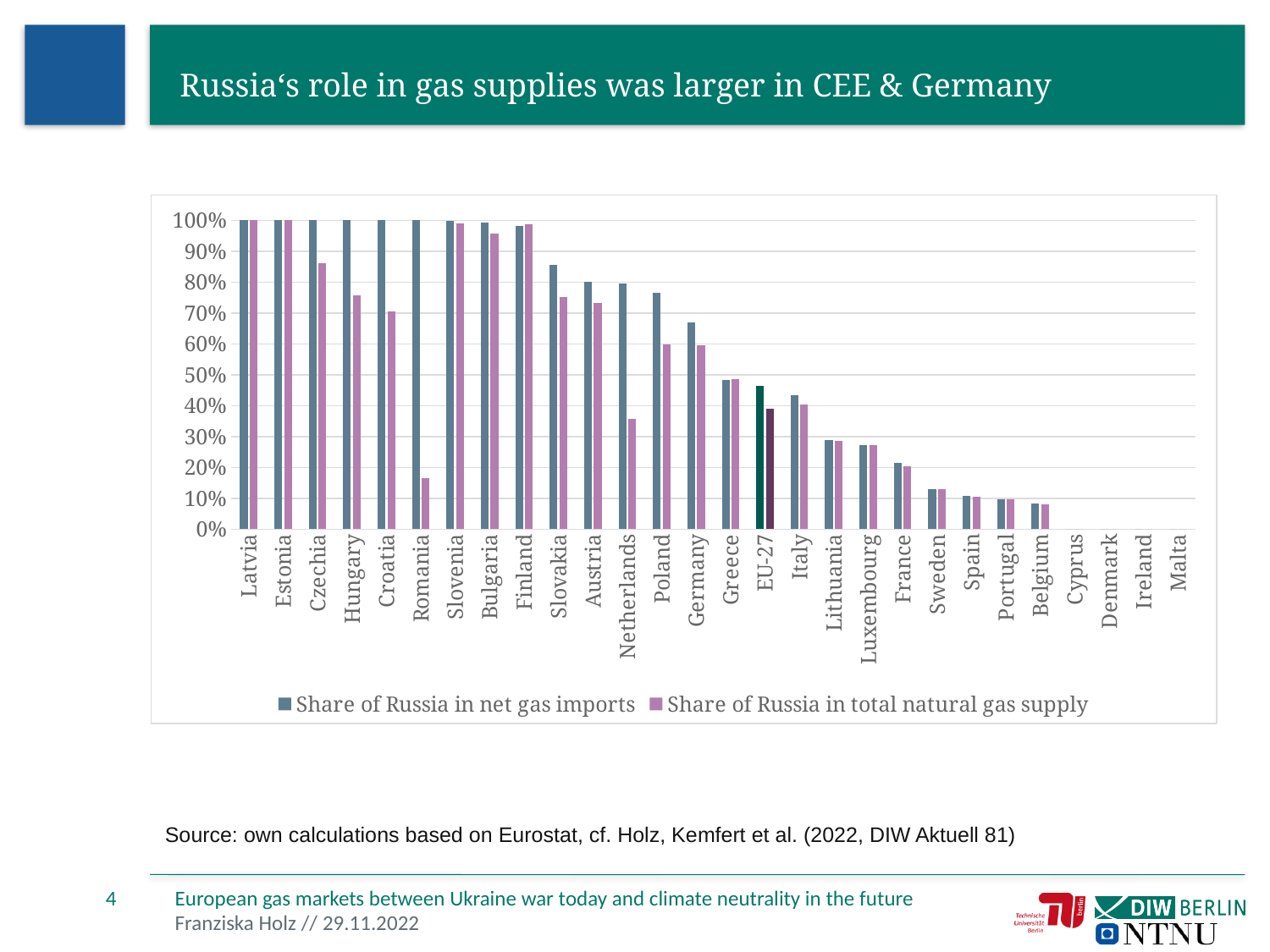
What is the title of the slide containing the chart? Russia's role in gas supplies was larger in CEE & Germany Is the share of Russia in total natural gas supply for the Netherlands greater or less than 40%? less What is the share of Russia in total natural gas supply for Estonia? 100% What is the share of Russia in net gas imports for Latvia? 100% How many countries/categories are shown on the x axis? 28 Do the values for the share of Russia in net gas imports generally rise or fall moving from left to right along the x axis? fall Is the share of Russia in total natural gas supply for Romania greater or less than 20%? less How many series does the legend list? 2 For the Netherlands, which is larger: the share of Russia in net gas imports or the share of Russia in total natural gas supply? Share of Russia in net gas imports Is the share of Russia in net gas imports for Slovakia greater or less than 80%? greater What kind of chart is shown on the slide? bar chart